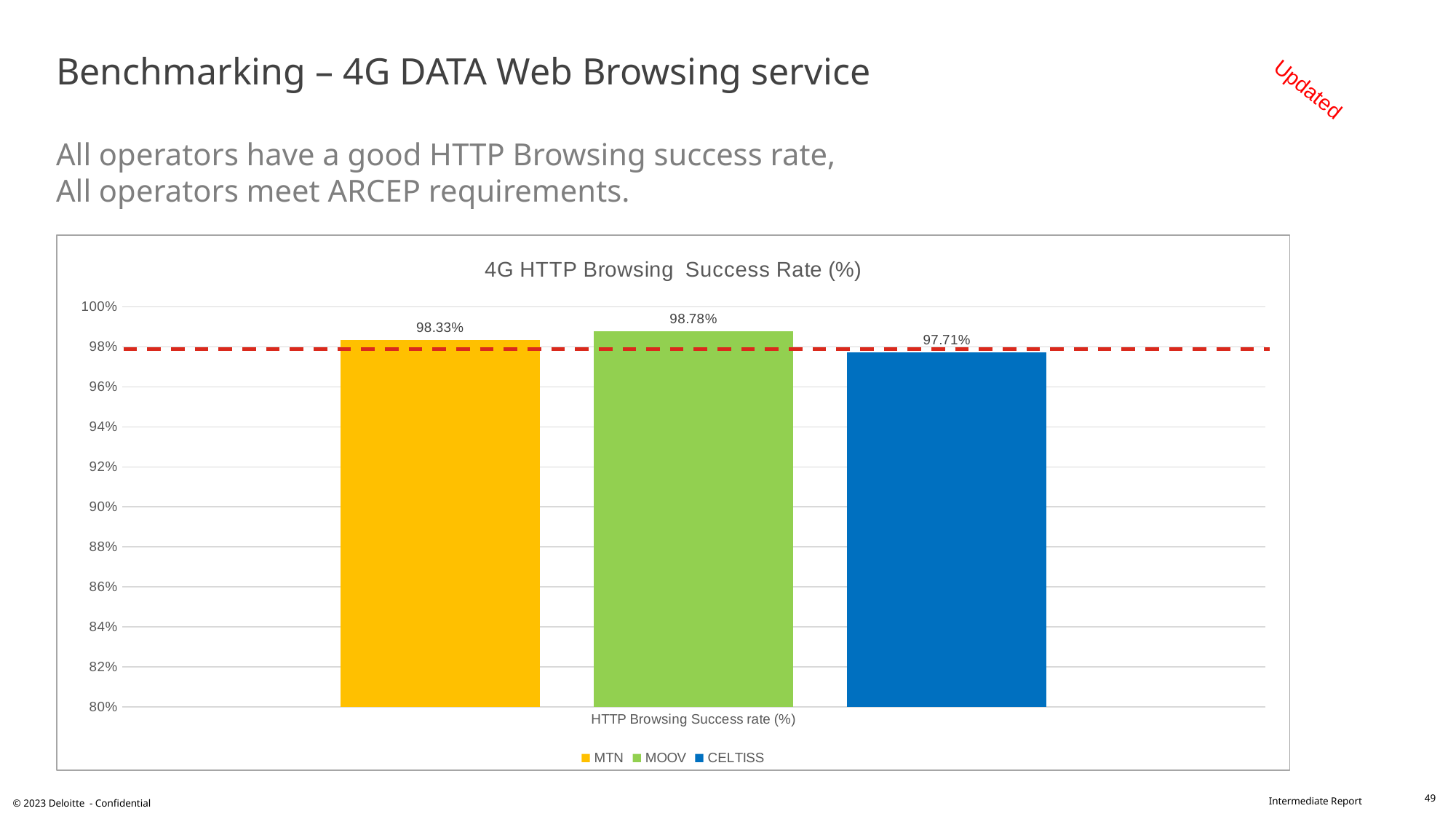
What is the HTTP Browsing Success rate for MTN? 98.33% Which operator has the lowest HTTP Browsing Success rate? CELTISS Which has a higher HTTP Browsing Success rate, MTN or CELTISS? MTN Is the value for CELTISS greater or less than 98%? less What kind of chart is shown on the slide? Bar chart Which operator has the highest HTTP Browsing Success rate? MOOV What is the difference between the MOOV and MTN HTTP Browsing Success rates? 0.45% How many series does the legend list? 3 What is the HTTP Browsing Success rate for CELTISS? 97.71% What is the title of the chart? 4G HTTP Browsing Success Rate (%) What is the difference between the MOOV and CELTISS HTTP Browsing Success rates? 1.07% What is the HTTP Browsing Success rate for MOOV? 98.78%